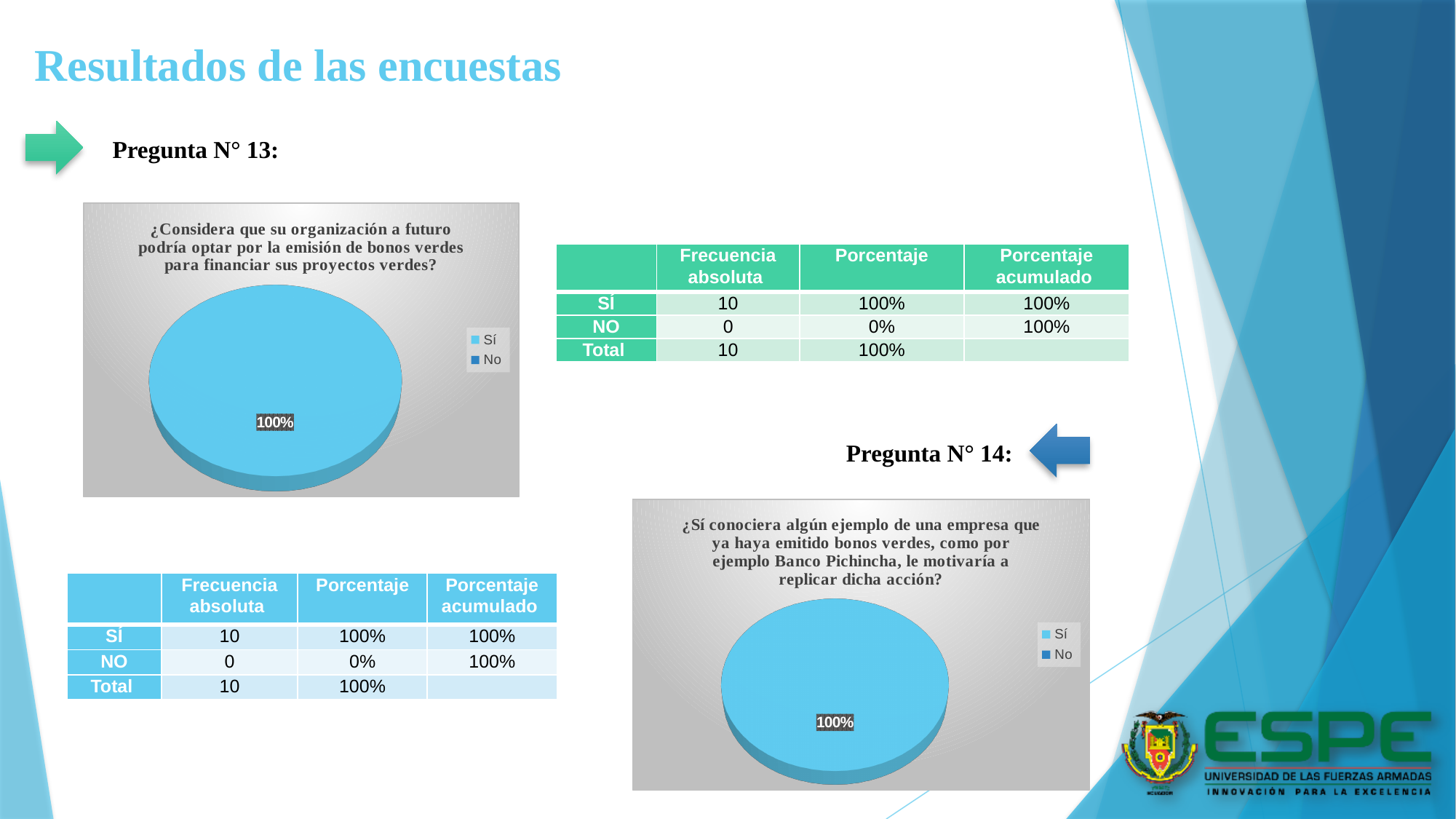
How many entries does the legend of the Pregunta N° 14 pie chart on the lower right list? 2 What type of chart is used for Pregunta N° 14 (the chart on the lower right)? pie chart What are the two legend entries shown in the Pregunta N° 13 pie chart on the left? Sí and No In the Pregunta N° 13 pie chart on the left, what share of the pie does Sí take? 100% How many entries does the legend of the Pregunta N° 13 pie chart on the left list? 2 In the Pregunta N° 13 pie chart on the left, which category has the largest slice? Sí In the Pregunta N° 14 pie chart on the lower right, which is larger, the Sí slice or the No slice? Sí In the Pregunta N° 14 pie chart on the lower right, which category has the largest slice? Sí In the Pregunta N° 13 pie chart on the left, which is larger, the Sí slice or the No slice? Sí In the Pregunta N° 14 pie chart on the lower right, what share of the pie does Sí take? 100% What colour is the Sí slice in the Pregunta N° 14 pie chart on the lower right? light blue What type of chart is used for Pregunta N° 13 (the chart on the left)? pie chart